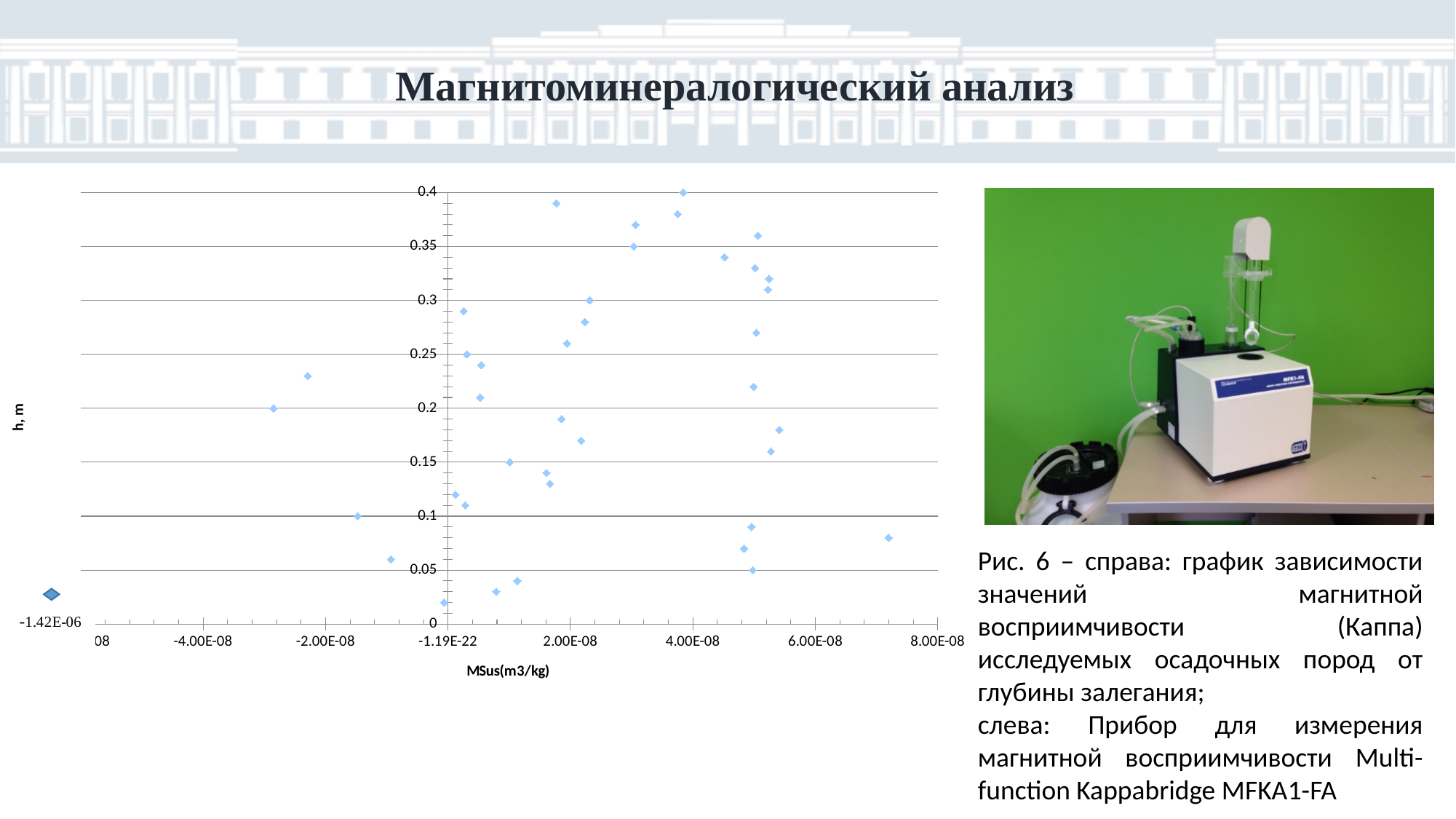
What kind of chart is shown on the slide? scatter chart For the point with the largest MSus value, is its h value greater or less than 0.1? less For the point with the largest h value, is its MSus value greater or less than 2.00E-08? greater What is the label of the horizontal axis of the chart? MSus(m3/kg) Is the MSus value of the rightmost point on the chart greater or less than 6.00E-08? greater What is the label of the vertical axis of the chart? h, m